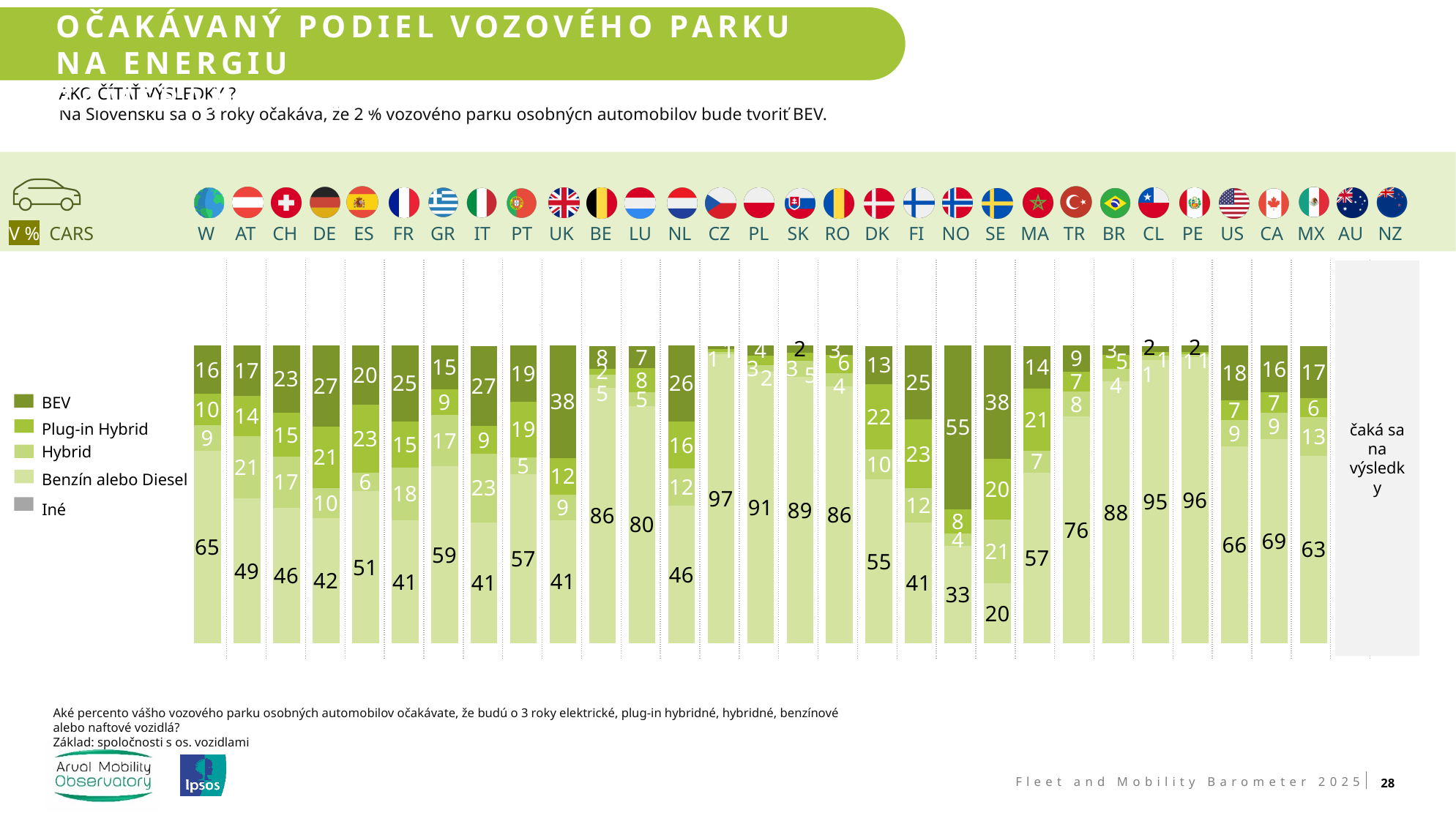
Which has a larger Benzín alebo Diesel value, BE or LU? BE How many series does the legend list? 5 Which country has the lowest Benzín alebo Diesel value? SE What is the BEV value for UK? 38 What is the Benzín alebo Diesel value for SK? 89 What is the Hybrid value for IT? 23 What is the Plug-in Hybrid value for DK? 22 Which country has the highest Benzín alebo Diesel value? CZ What is the difference between the BEV values for DE and AT? 10 Which two countries are marked as awaiting results (čaká sa na výsledky)? AU and NZ What type of chart is shown on the slide? stacked bar chart Which country has the highest BEV value? NO